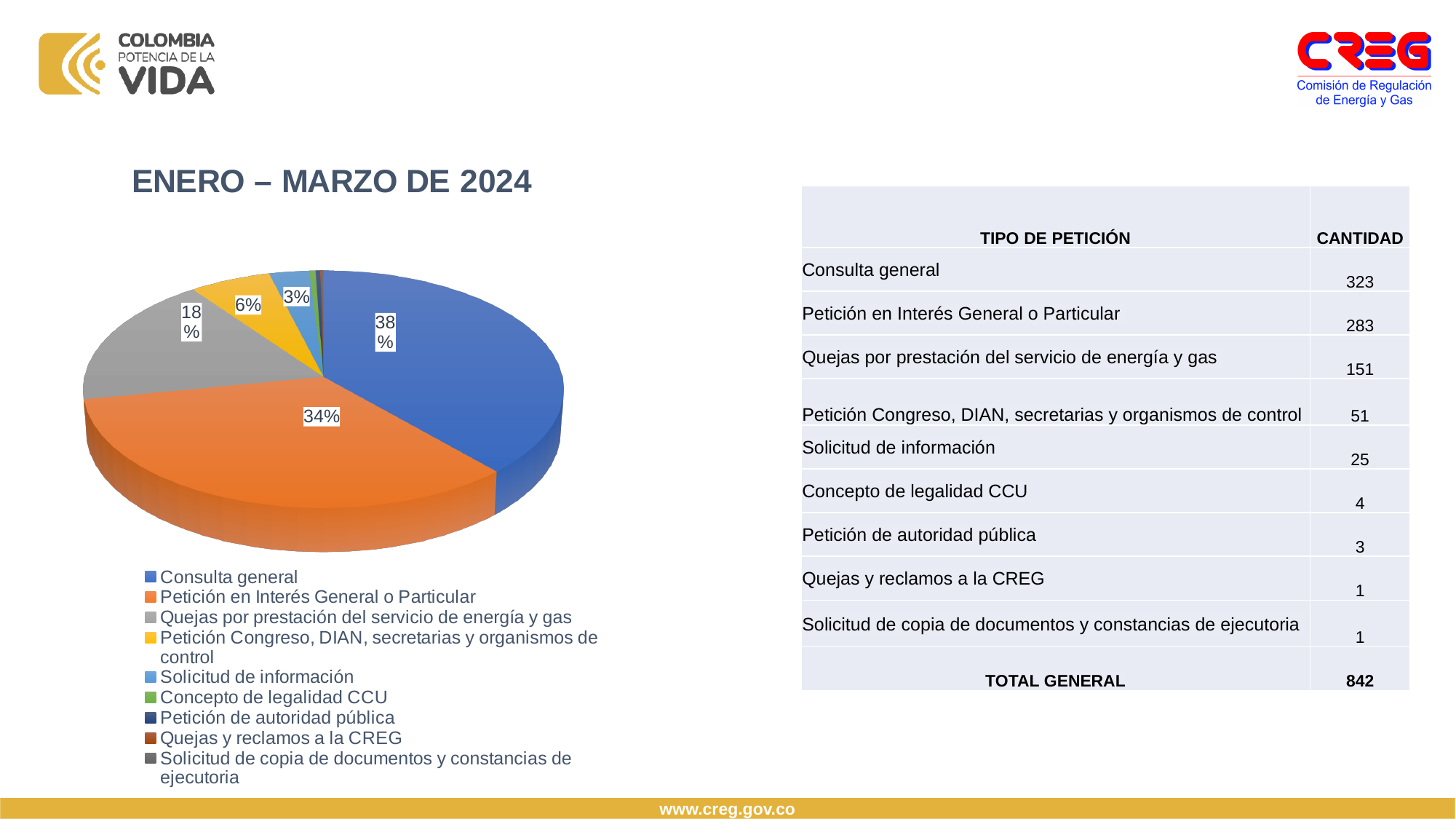
Which category has the largest slice of the pie? Consulta general What is the difference in percentage points between the Consulta general slice and the Petición en Interés General o Particular slice? 4% What kind of chart is shown on the slide? pie chart What share of the pie does Petición en Interés General o Particular represent? 34% What percentage is shown for Petición Congreso, DIAN, secretarias y organismos de control? 6% How many categories does the pie chart legend list? 9 What percentage is shown for Quejas por prestación del servicio de energía y gas? 18% What percentage is shown for Solicitud de información? 3% What share of the pie does Consulta general represent? 38% Which slice is larger: Quejas por prestación del servicio de energía y gas or Petición Congreso, DIAN, secretarias y organismos de control? Quejas por prestación del servicio de energía y gas What is the title shown above the pie chart? ENERO – MARZO DE 2024 What colour represents Consulta general in the pie chart? blue